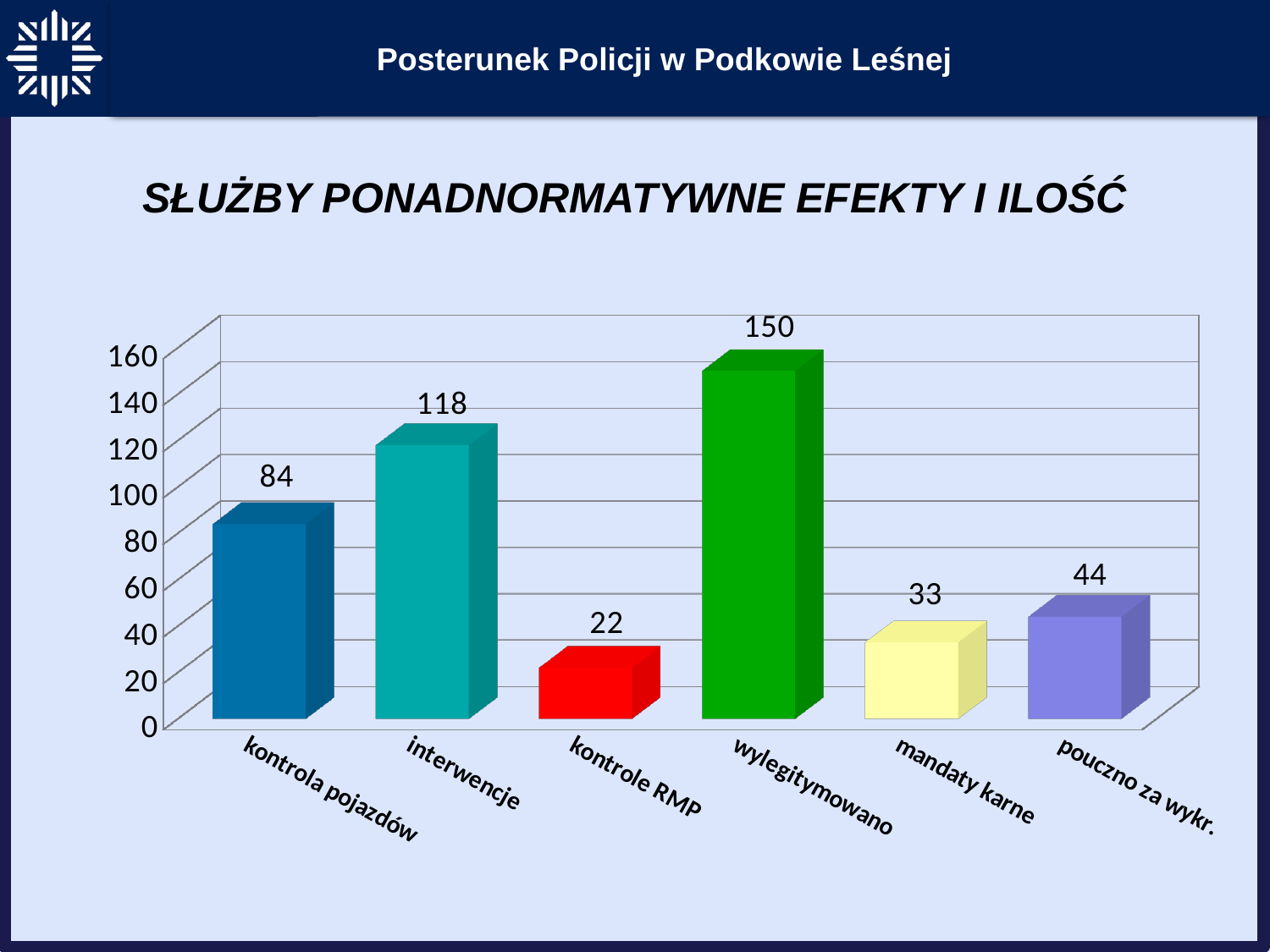
What is the value for mandaty karne? 33 Which category has the highest value? wylegitymowano What kind of chart is shown on the slide? bar chart How many categories are shown in the chart? 6 What is the value for kontrole RMP? 22 What is the value for kontrola pojazdów? 84 What is the difference between the values for pouczno za wykr. and mandaty karne? 11 What is the value for interwencje? 118 What is the title of the chart? SŁUŻBY PONADNORMATYWNE EFEKTY I ILOŚĆ What is the difference between the values for wylegitymowano and interwencje? 32 Which is larger, the value for kontrola pojazdów or the value for pouczno za wykr.? kontrola pojazdów Which category has the lowest value? kontrole RMP